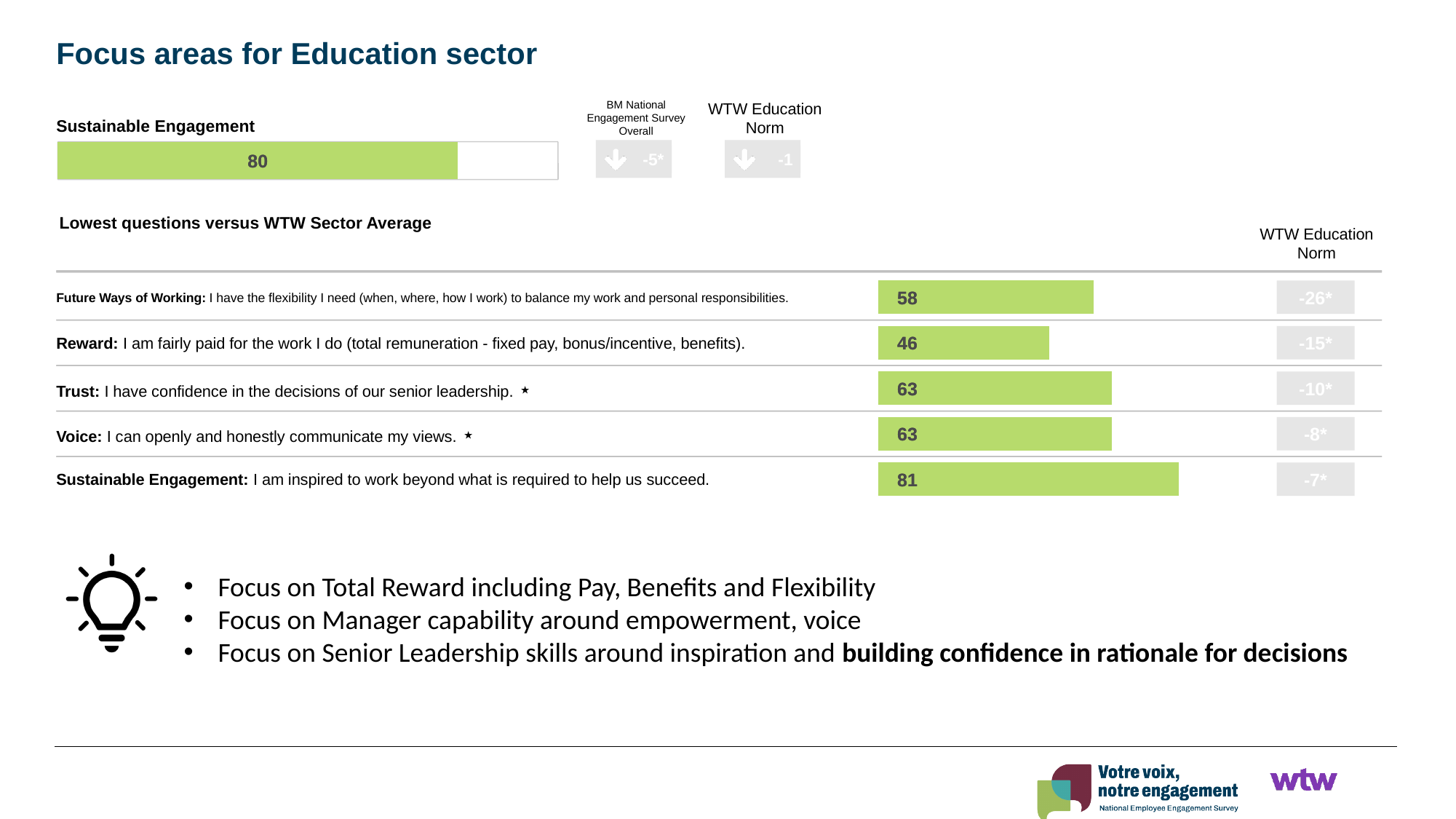
In the 'Lowest questions versus WTW Sector Average' chart, what is the score for the Trust question? 63 In the 'Lowest questions versus WTW Sector Average' chart, what is the difference between the Sustainable Engagement score and the Reward score? 35 In the 'Lowest questions versus WTW Sector Average' chart, which question has the lowest score? Reward What is the Sustainable Engagement score shown in the bar at the top of the slide? 80 In the 'Lowest questions versus WTW Sector Average' chart, which has the higher score, Future Ways of Working or Voice? Voice In the 'Lowest questions versus WTW Sector Average' chart, what is the WTW Education Norm difference shown for the Future Ways of Working question? -26* How many questions are listed in the 'Lowest questions versus WTW Sector Average' chart? 5 In the 'Lowest questions versus WTW Sector Average' chart, what is the score for the Future Ways of Working question? 58 What is the BM National Engagement Survey Overall difference shown next to the Sustainable Engagement bar? -5* In the 'Lowest questions versus WTW Sector Average' chart, which question has the highest score? Sustainable Engagement What type of chart is used to show the scores in the 'Lowest questions versus WTW Sector Average' section? Bar chart In the 'Lowest questions versus WTW Sector Average' chart, what is the score for the Reward question? 46